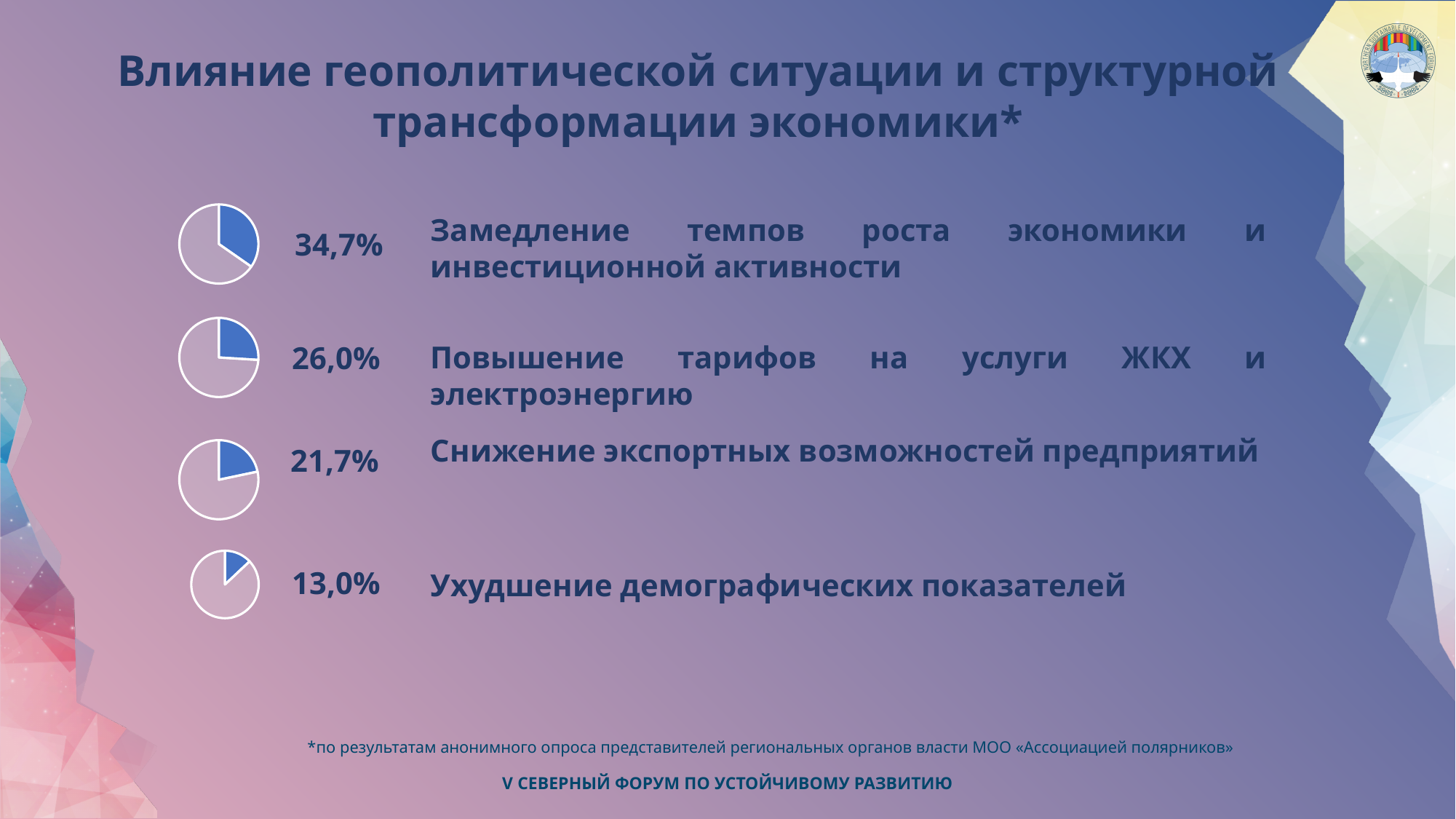
Which item has the lowest percentage on the slide? Ухудшение демографических показателей What kind of chart is used to show each percentage on the slide? Pie chart What is the difference between the percentage for "Повышение тарифов на услуги ЖКХ и электроэнергию" and the percentage for "Снижение экспортных возможностей предприятий"? 4,3% Which item has the highest percentage on the slide? Замедление темпов роста экономики и инвестиционной активности What percentage is shown for "Ухудшение демографических показателей"? 13,0% What percentage is shown for "Замедление темпов роста экономики и инвестиционной активности"? 34,7% What is the difference between the percentage for "Замедление темпов роста экономики и инвестиционной активности" and the percentage for "Ухудшение демографических показателей"? 21,7% What percentage is shown for "Повышение тарифов на услуги ЖКХ и электроэнергию"? 26,0% How many pie charts are shown on the slide? 4 What colour is the highlighted slice in each pie chart? Blue Which is larger: the percentage for "Повышение тарифов на услуги ЖКХ и электроэнергию" or the percentage for "Снижение экспортных возможностей предприятий"? Повышение тарифов на услуги ЖКХ и электроэнергию What percentage is shown for "Снижение экспортных возможностей предприятий"? 21,7%